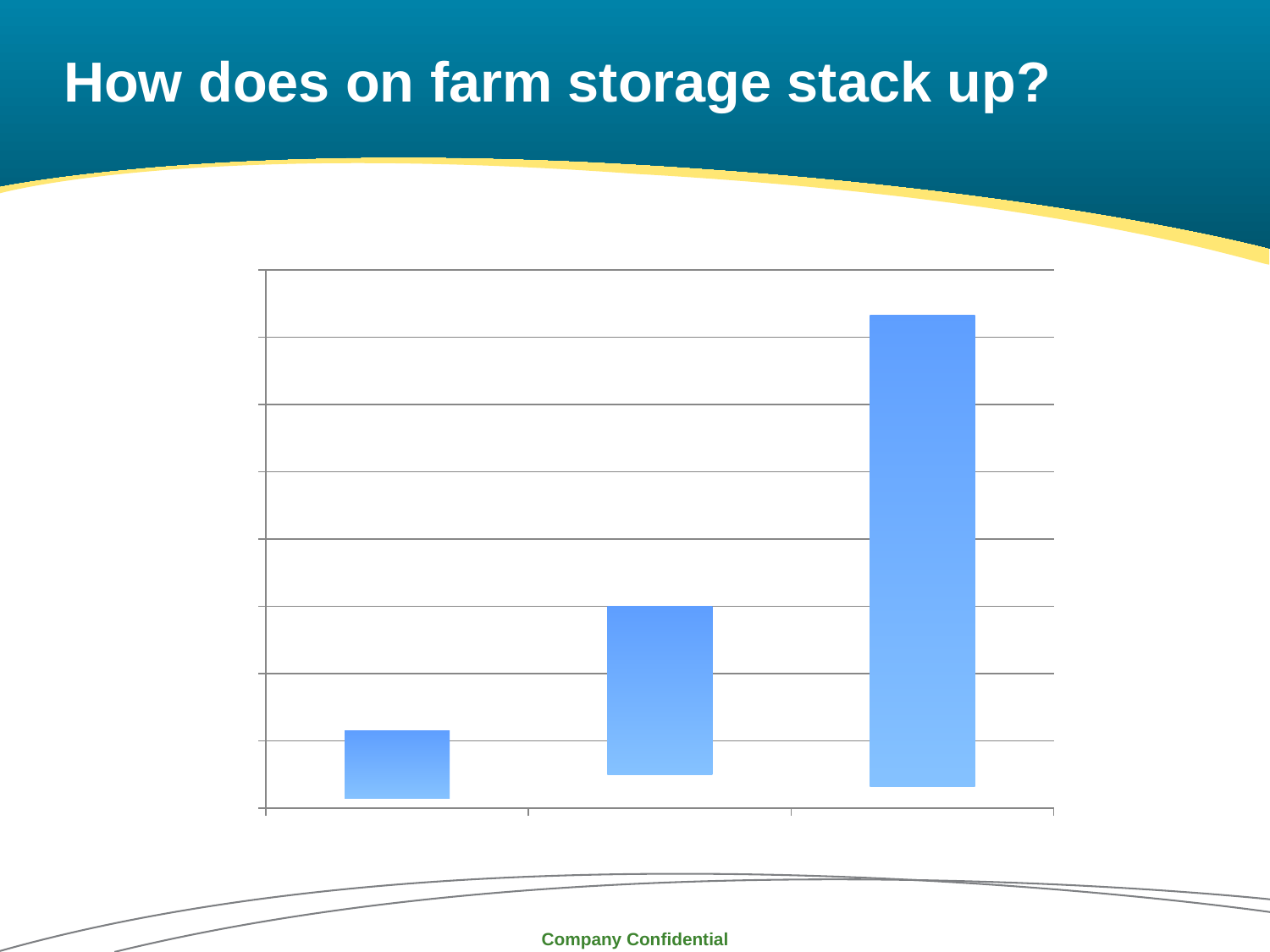
What colour are the bars in the chart? blue How many bars are plotted in the chart? 3 Do the bar heights rise or fall from left to right across the chart? rise Which is taller, the middle bar or the left bar? middle bar Which bar is the shortest in the chart: the left, middle, or right one? left Which is taller, the middle bar or the right bar? right bar Which bar is the tallest in the chart: the left, middle, or right one? right What is the title of the slide containing the chart? How does on farm storage stack up? What kind of chart is shown on the slide? bar chart